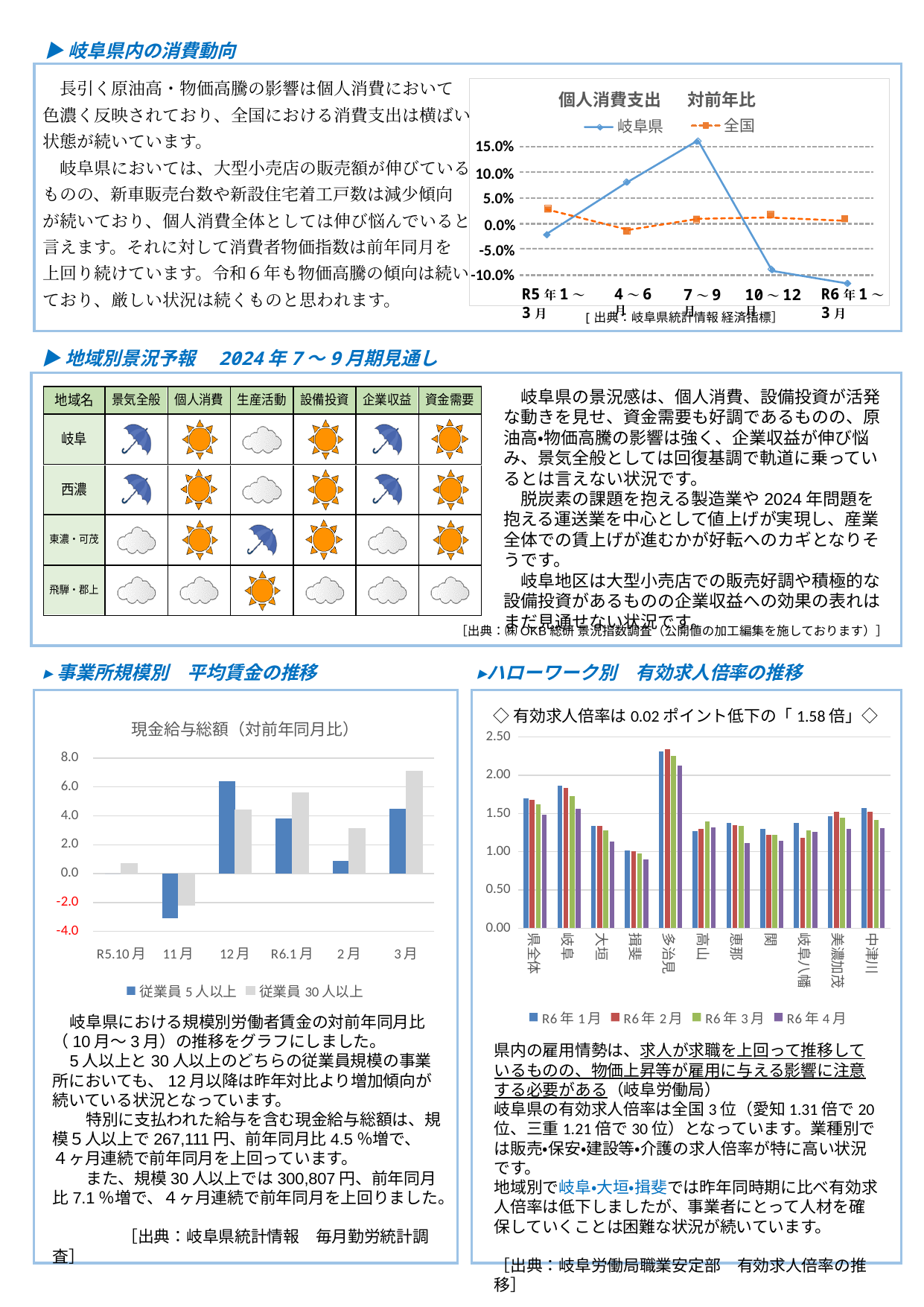
In the 個人消費支出 対前年比 chart, how many series does the legend list? 2 In the 有効求人倍率 chart at the bottom right, how many series does the legend list? 4 In the 現金給与総額（対前年同月比） chart, is the 従業員30人以上 value for 3月 greater or less than 6.0? greater In the 個人消費支出 対前年比 chart, at which period does the 岐阜県 line reach its highest value? 7～9月 What kind of chart is the 現金給与総額（対前年同月比） chart at the bottom left? bar chart In the 有効求人倍率 chart at the bottom right, which Hello Work area has the highest values? 多治見 In the 現金給与総額（対前年同月比） chart, how many months are shown on the x axis? 6 What kind of chart is the 個人消費支出 対前年比 chart at the top of the slide? line chart In the 個人消費支出 対前年比 chart, is the 岐阜県 value for 7～9月 greater or less than 10.0%? greater In the 現金給与総額（対前年同月比） chart, which is larger for 2月: 従業員5人以上 or 従業員30人以上? 従業員30人以上 In the 個人消費支出 対前年比 chart, is the 岐阜県 value for R6年1～3月 greater or less than -10.0%? less In the 現金給与総額（対前年同月比） chart, which month has the highest value for 従業員5人以上? 12月